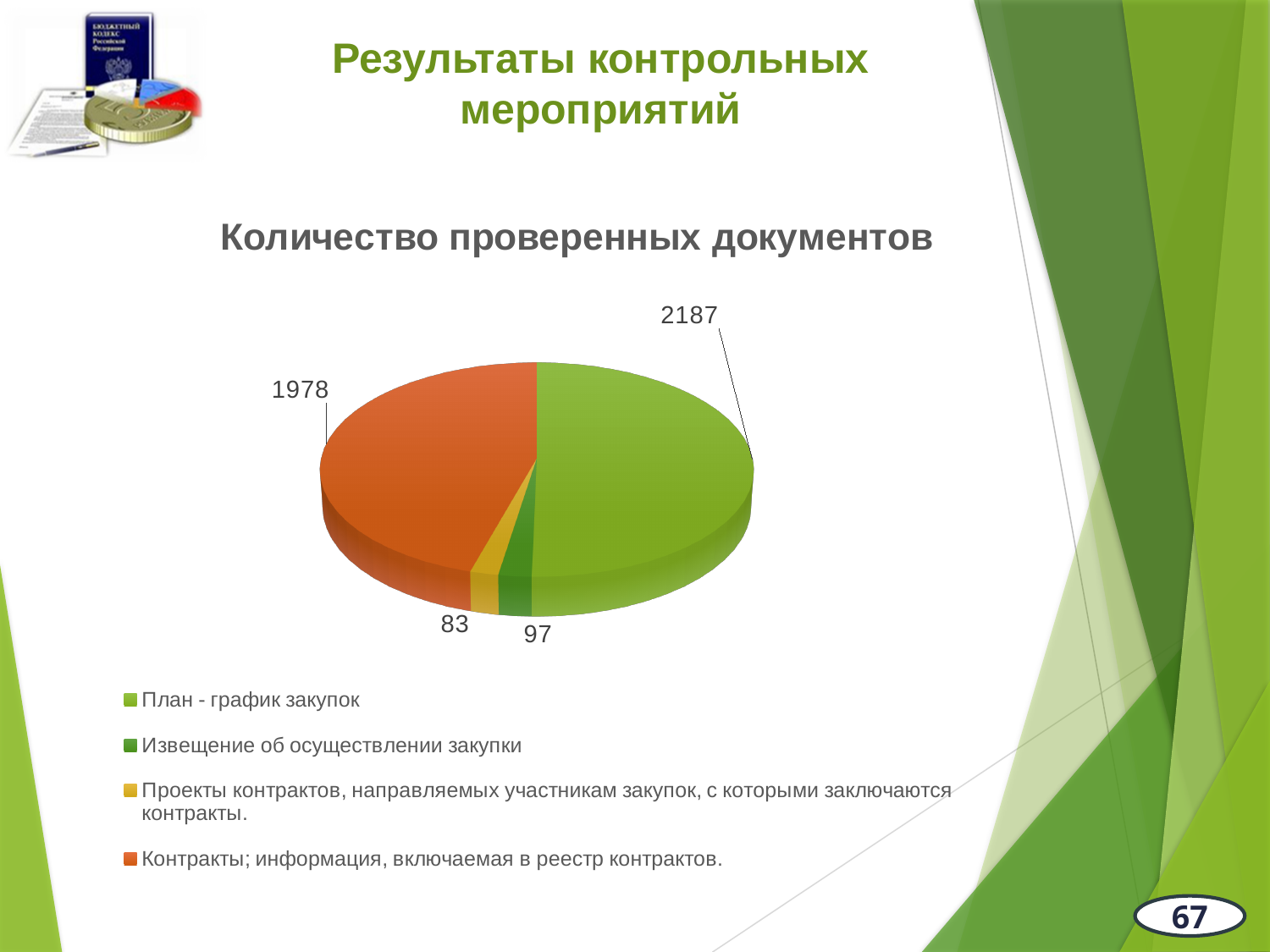
What is the value for "Контракты; информация, включаемая в реестр контрактов."? 1978 How many slices does the pie chart have? 4 What is the difference between the values for "План - график закупок" and "Контракты; информация, включаемая в реестр контрактов."? 209 What is the value for "Проекты контрактов, направляемых участникам закупок, с которыми заключаются контракты."? 83 What is the value for "Извещение об осуществлении закупки"? 97 Which category has the largest slice of the pie? План - график закупок Which category has the smallest slice of the pie? Проекты контрактов, направляемых участникам закупок, с которыми заключаются контракты. What is the total of all four values shown on the pie chart? 4345 What is the value for "План - график закупок"? 2187 What kind of chart is shown on the slide? pie chart How many entries does the legend list? 4 What is the title of the chart? Количество проверенных документов